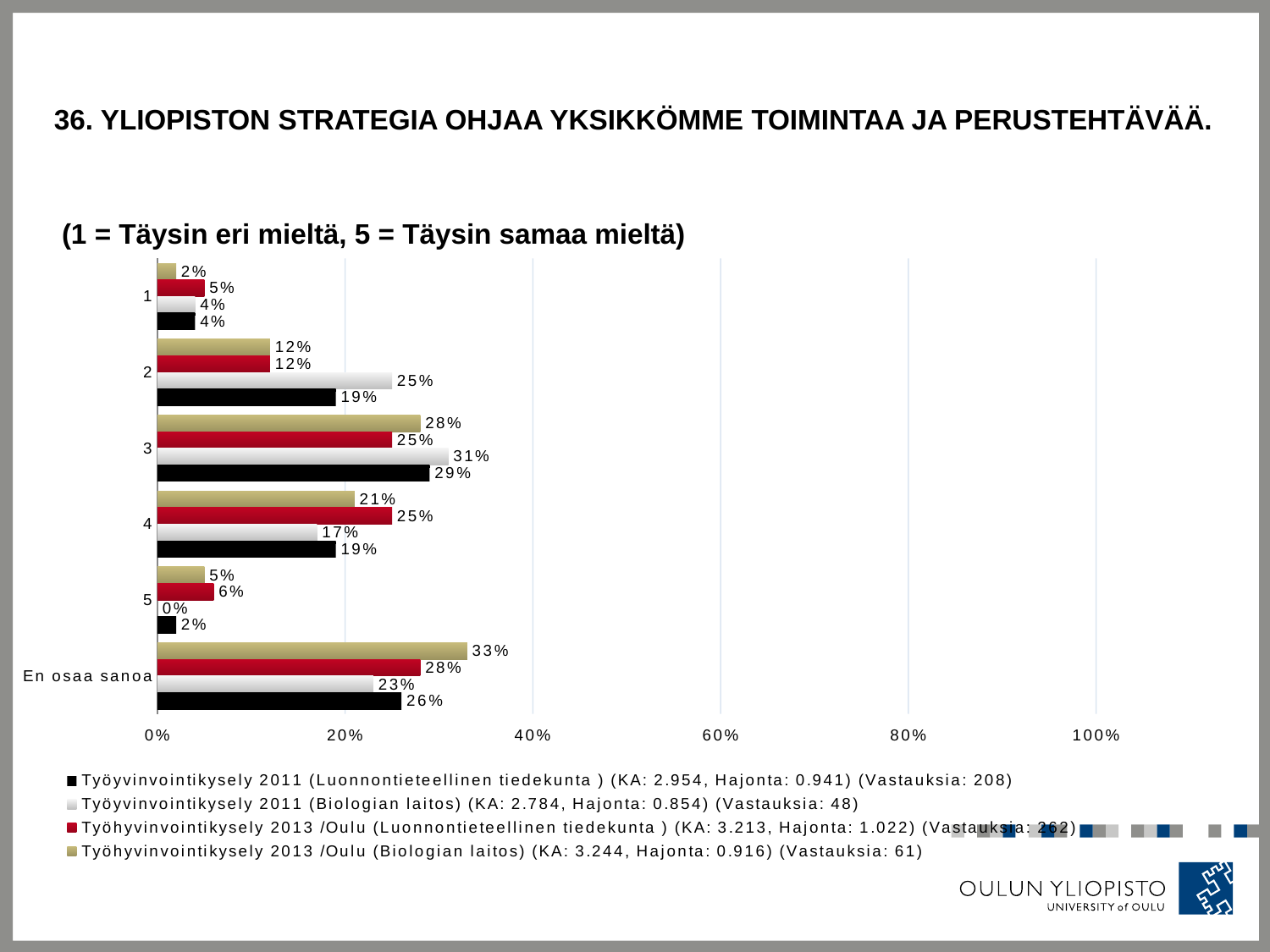
What is the value for 'En osaa sanoa' in the Työyvinvointikysely 2011 (Luonnontieteellinen tiedekunta) series? 26% Which category has the lowest value in the Työyvinvointikysely 2011 (Biologian laitos) series? 5 What is the difference between the Työyvinvointikysely 2011 (Biologian laitos) value and the Työhyvinvointikysely 2013 /Oulu (Biologian laitos) value for category 2? 13% Which category has the highest value in the Työhyvinvointikysely 2013 /Oulu (Biologian laitos) series? En osaa sanoa How many responses (Vastauksia) does the legend give for the Työhyvinvointikysely 2013 /Oulu (Luonnontieteellinen tiedekunta) series? 262 What is the value for category 5 in the Työhyvinvointikysely 2013 /Oulu (Luonnontieteellinen tiedekunta) series? 6% What is the value for category 3 in the Työhyvinvointikysely 2013 /Oulu (Biologian laitos) series? 28% What is the value for category 2 in the Työyvinvointikysely 2011 (Biologian laitos) series? 25% What kind of chart is shown on the slide? bar chart For category 4, which is larger: the Työhyvinvointikysely 2013 /Oulu (Luonnontieteellinen tiedekunta) value or the Työyvinvointikysely 2011 (Biologian laitos) value? Työhyvinvointikysely 2013 /Oulu (Luonnontieteellinen tiedekunta) How many series does the legend list? 4 How many categories are shown on the vertical axis of the chart? 6